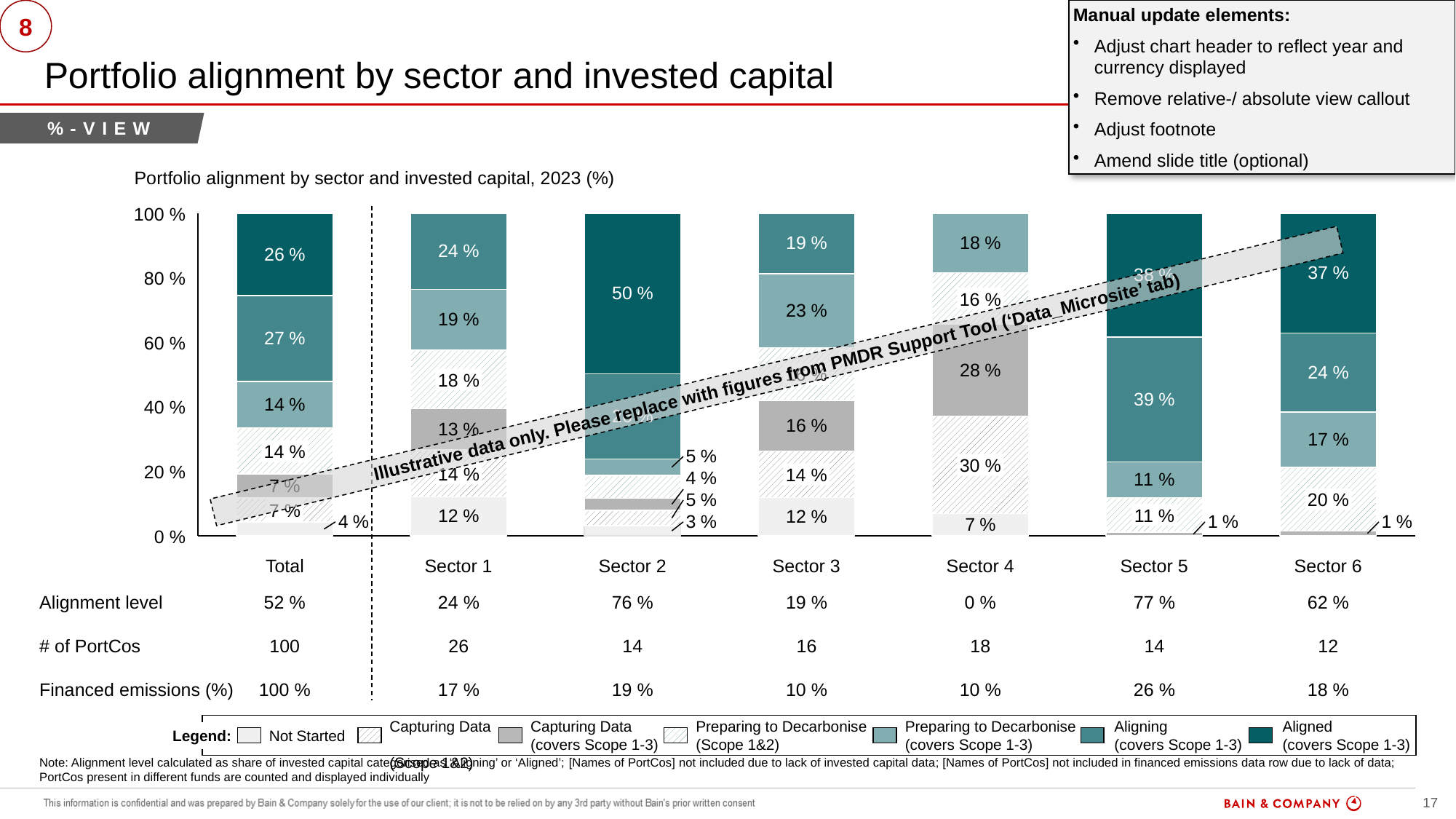
What is the 'Capturing Data (covers Scope 1-3)' share for Sector 4? 28 % Which sector has the largest 'Aligned (covers Scope 1-3)' segment? Sector 2 What is the 'Not Started' share for Sector 4? 7 % What is the 'Aligned (covers Scope 1-3)' share for Sector 2? 50 % What is the title of the chart? Portfolio alignment by sector and invested capital, 2023 (%) How many categories (bars) are shown on the x axis of the chart? 7 What is the 'Aligned (covers Scope 1-3)' share for the Total bar? 26 % For Sector 6, what is the difference between the 'Aligned (covers Scope 1-3)' share and the 'Aligning (covers Scope 1-3)' share? 13 % How many series does the chart legend list? 7 What kind of chart is shown on the slide? Stacked bar chart What is the 'Aligning (covers Scope 1-3)' share for Sector 5? 39 %